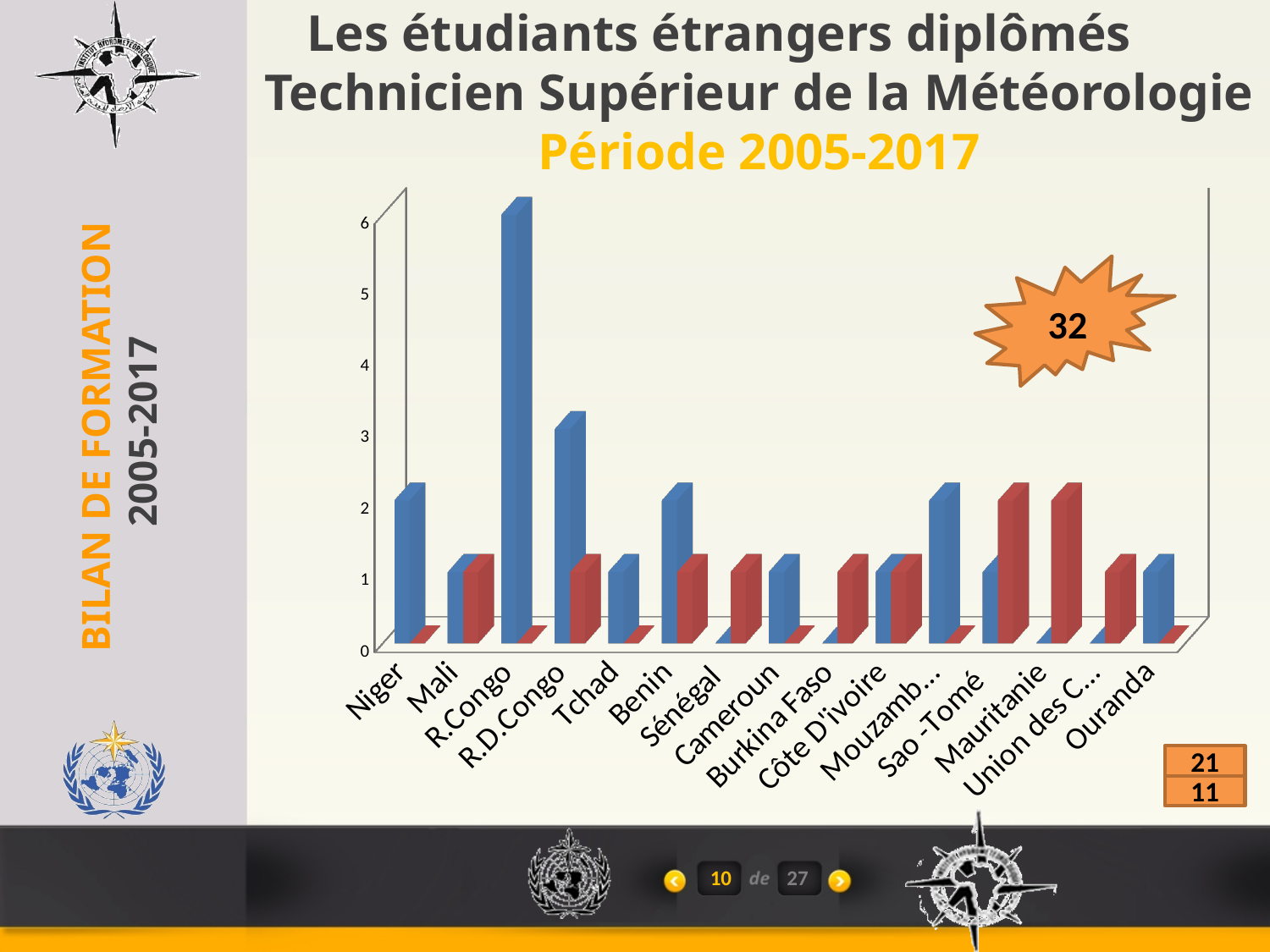
Which is larger, the blue bar for R.Congo or the blue bar for R.D.Congo? R.Congo How many countries (categories) are shown along the x axis of the chart? 15 Is the blue bar for R.Congo greater or less than 5? greater Is the red bar for Mauritanie greater or less than 1? greater Which is larger, the red bar for Mauritanie or the red bar for Mali? Mauritanie What period is stated in the chart's title? 2005-2017 What kind of chart is shown on the slide? bar chart Is the blue bar for R.D.Congo greater or less than 2? greater How many bar series (colours) are plotted in the chart? 2 Which country has the tallest blue bar in the chart? R.Congo